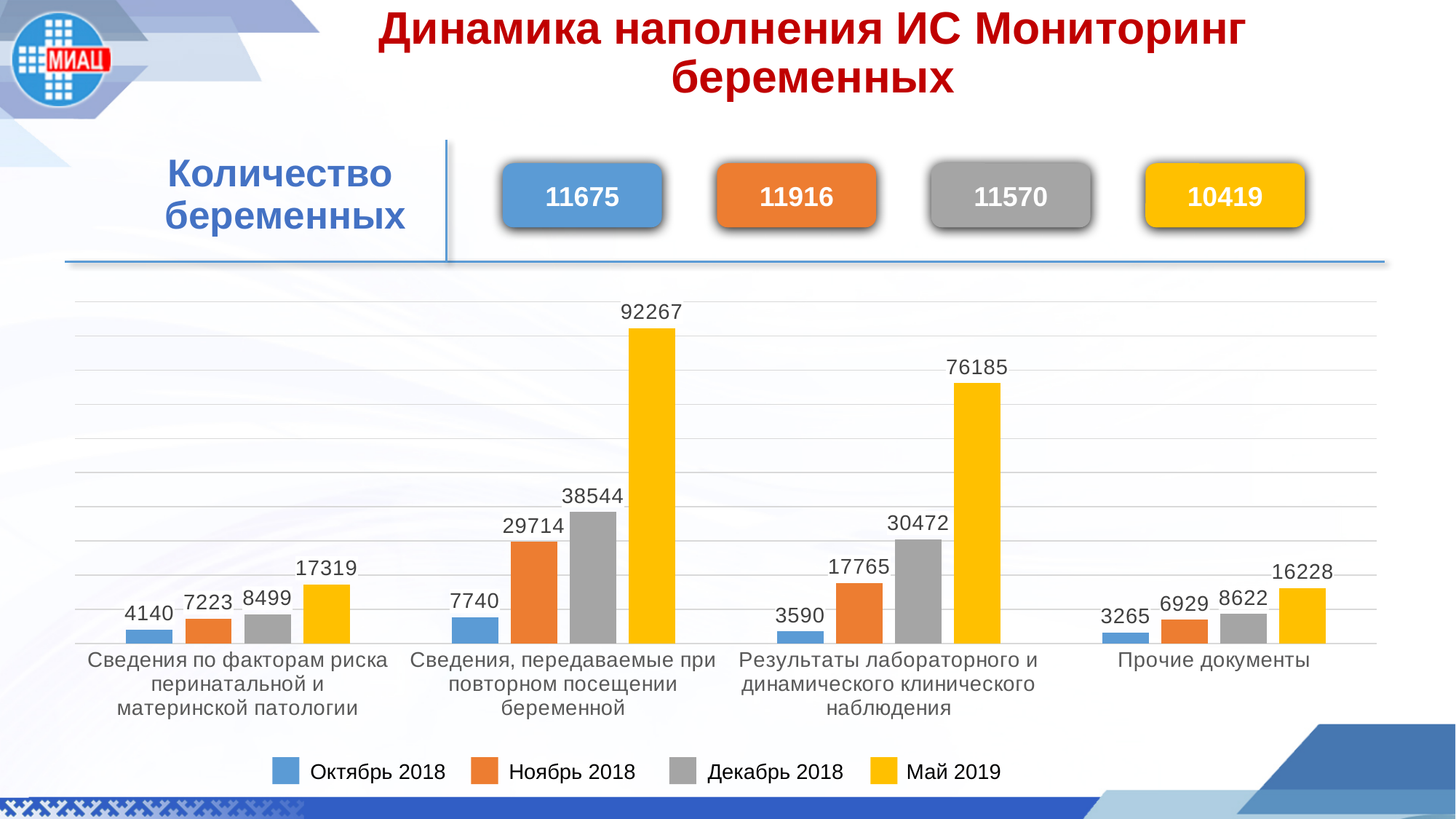
Which colour represents Май 2019 in the chart legend? yellow What is the value for Май 2019 in the category 'Сведения, передаваемые при повторном посещении беременной'? 92267 What is the difference between the Май 2019 and Декабрь 2018 values in the category 'Сведения, передаваемые при повторном посещении беременной'? 53723 Which category has the highest value for Май 2019? Сведения, передаваемые при повторном посещении беременной What is the value for Октябрь 2018 in the category 'Прочие документы'? 3265 How many categories are shown on the x axis of the chart? 4 What is the value for Декабрь 2018 in the category 'Результаты лабораторного и динамического клинического наблюдения'? 30472 What type of chart is shown on the slide? bar chart Which category has the lowest value for Октябрь 2018? Прочие документы Which is larger: the Ноябрь 2018 value for 'Результаты лабораторного и динамического клинического наблюдения' or the Ноябрь 2018 value for 'Сведения по факторам риска перинатальной и материнской патологии'? Результаты лабораторного и динамического клинического наблюдения How many series does the legend list? 4 Do the values rise or fall from Октябрь 2018 to Май 2019 in the category 'Прочие документы'? rise